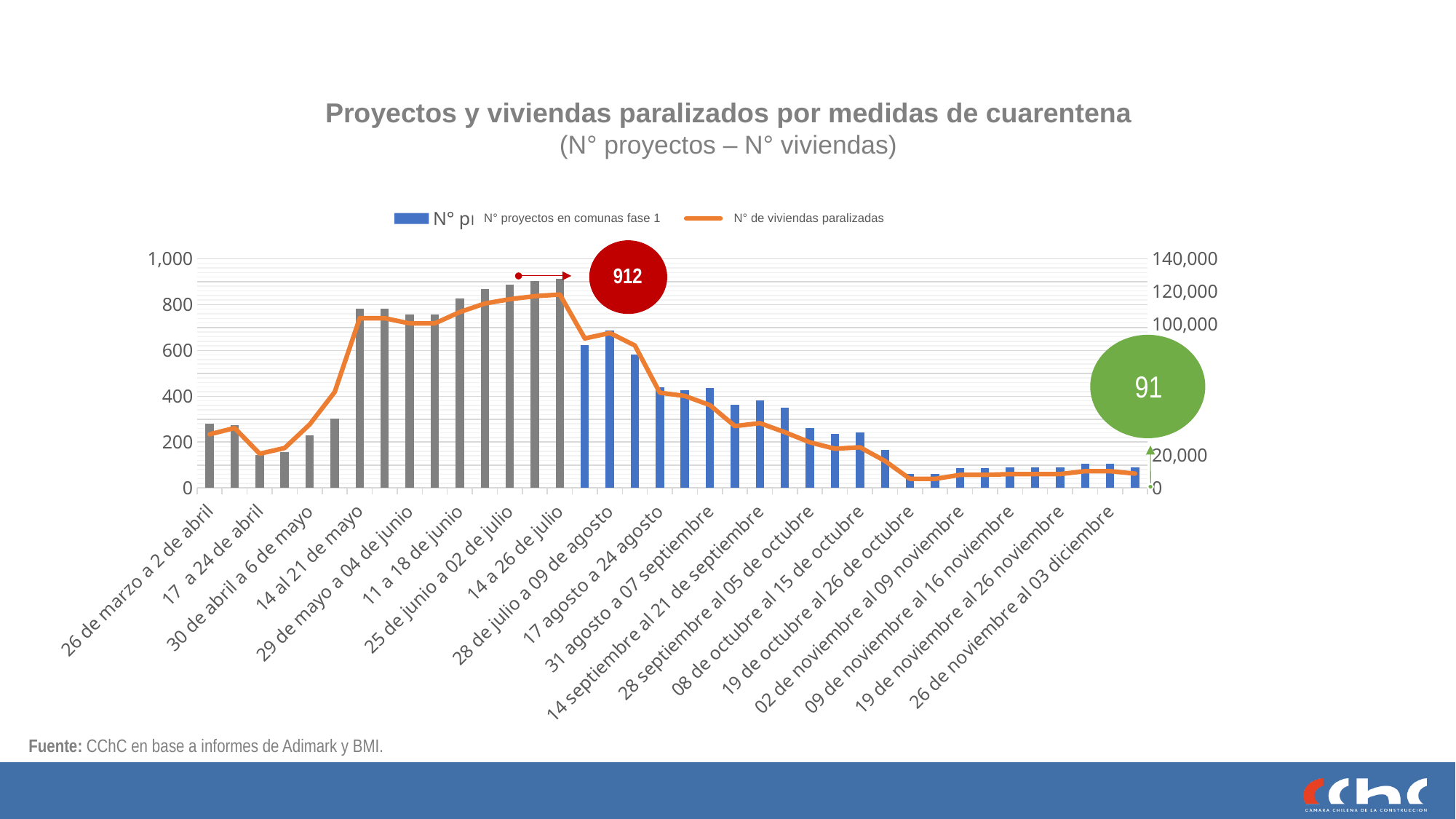
Is the number of projects for '26 de marzo a 2 de abril' greater or less than 400? less How many series does the legend list? 2 What kind of chart is shown on the slide? A combined bar and line chart What is the highest value shown on the right-hand axis? 140,000 What value is highlighted in the green circle at the right end of the chart? 91 Which series is drawn as an orange line? N° de viviendas paralizadas Do the number of projects rise or fall from '14 a 26 de julio' to '26 de noviembre al 03 diciembre'? fall Is the number of projects for '14 al 21 de mayo' greater or less than 600? greater Is the number of projects for '26 de noviembre al 03 diciembre' greater or less than 200? less What is the title of the chart? Proyectos y viviendas paralizados por medidas de cuarentena (N° proyectos – N° viviendas) Which period has more projects: '17 a 24 de abril' or '14 al 21 de mayo'? 14 al 21 de mayo What peak value is highlighted in the red circle on the chart? 912